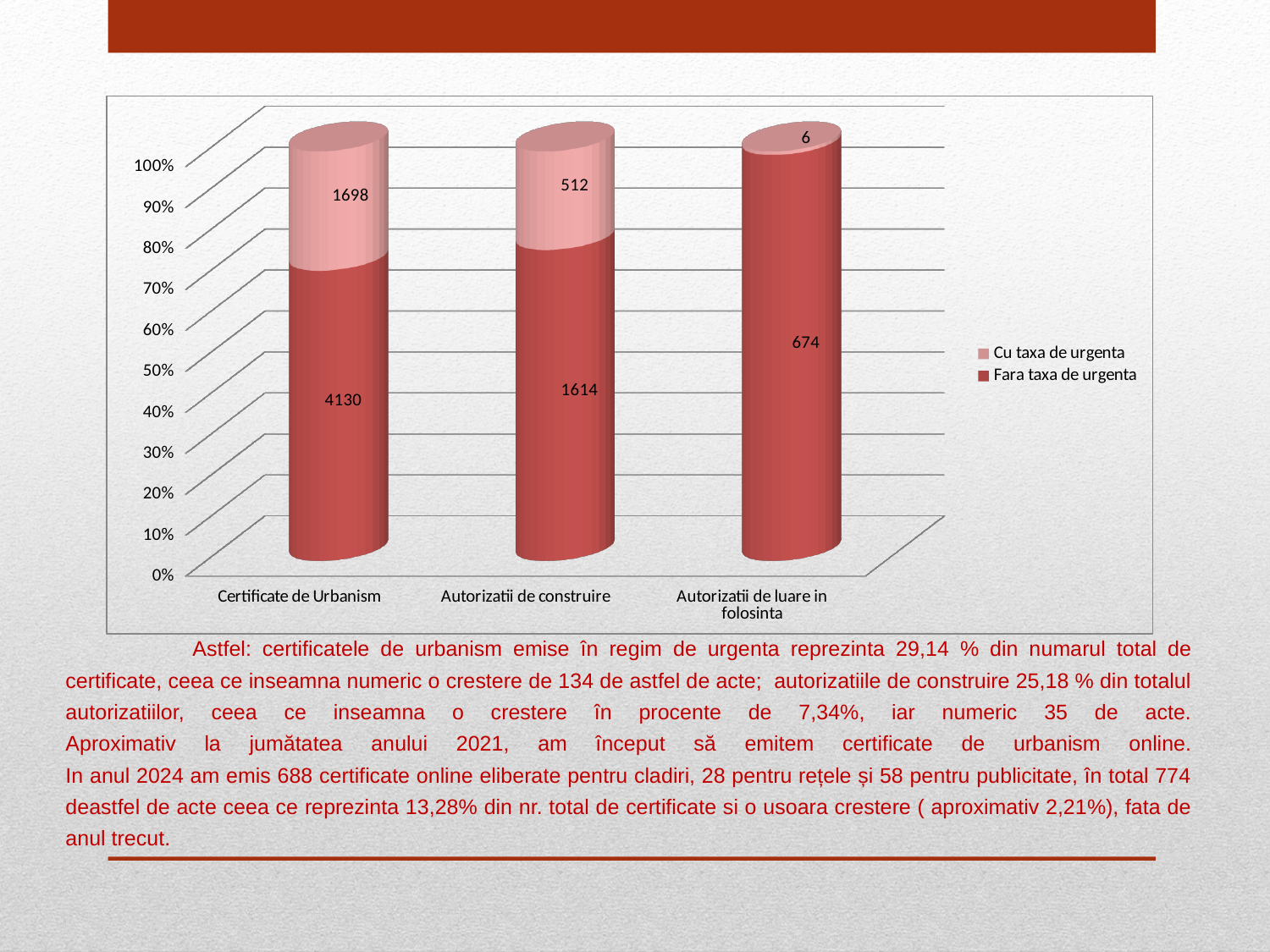
What is the value for "Cu taxa de urgenta" in the Autorizatii de luare in folosinta category? 6 What kind of chart is shown on the slide? Stacked bar chart Which is larger: the "Cu taxa de urgenta" value for Certificate de Urbanism or the "Fara taxa de urgenta" value for Autorizatii de construire? Cu taxa de urgenta for Certificate de Urbanism How many categories are shown on the x axis? 3 What is the value for "Cu taxa de urgenta" in the Autorizatii de construire category? 512 What is the difference between the "Fara taxa de urgenta" and "Cu taxa de urgenta" values for Autorizatii de construire? 1102 Which category has the highest value for "Fara taxa de urgenta"? Certificate de Urbanism What is the value for "Fara taxa de urgenta" in the Certificate de Urbanism category? 4130 What is the total of the two series for the Certificate de Urbanism bar? 5828 How many series does the legend list? 2 Which category has the lowest value for "Cu taxa de urgenta"? Autorizatii de luare in folosinta What is the value for "Fara taxa de urgenta" in the Autorizatii de luare in folosinta category? 674